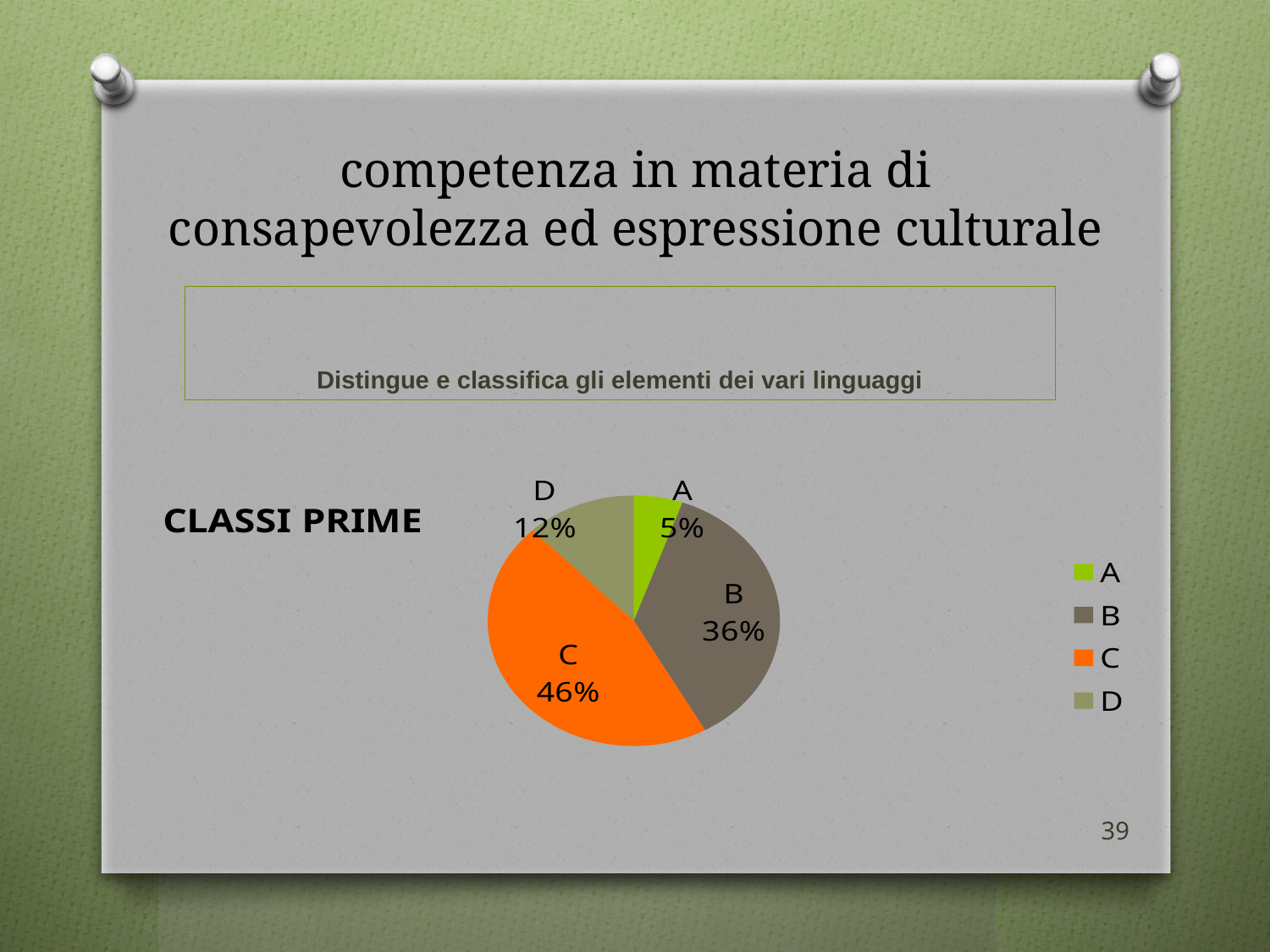
What is the difference in percentage points between slice C and slice B? 10 Which slice of the pie is the largest? C What percentage of the pie does slice C represent? 46% How many slices does the pie chart have? 4 Which is larger, slice D or slice A? D What percentage of the pie does slice B represent? 36% Which slice of the pie is the smallest? A What kind of chart is shown on the slide? pie chart What colour is slice C in the pie chart? orange What percentage of the pie does slice D represent? 12% How many entries does the legend list? 4 What percentage of the pie does slice A represent? 5%